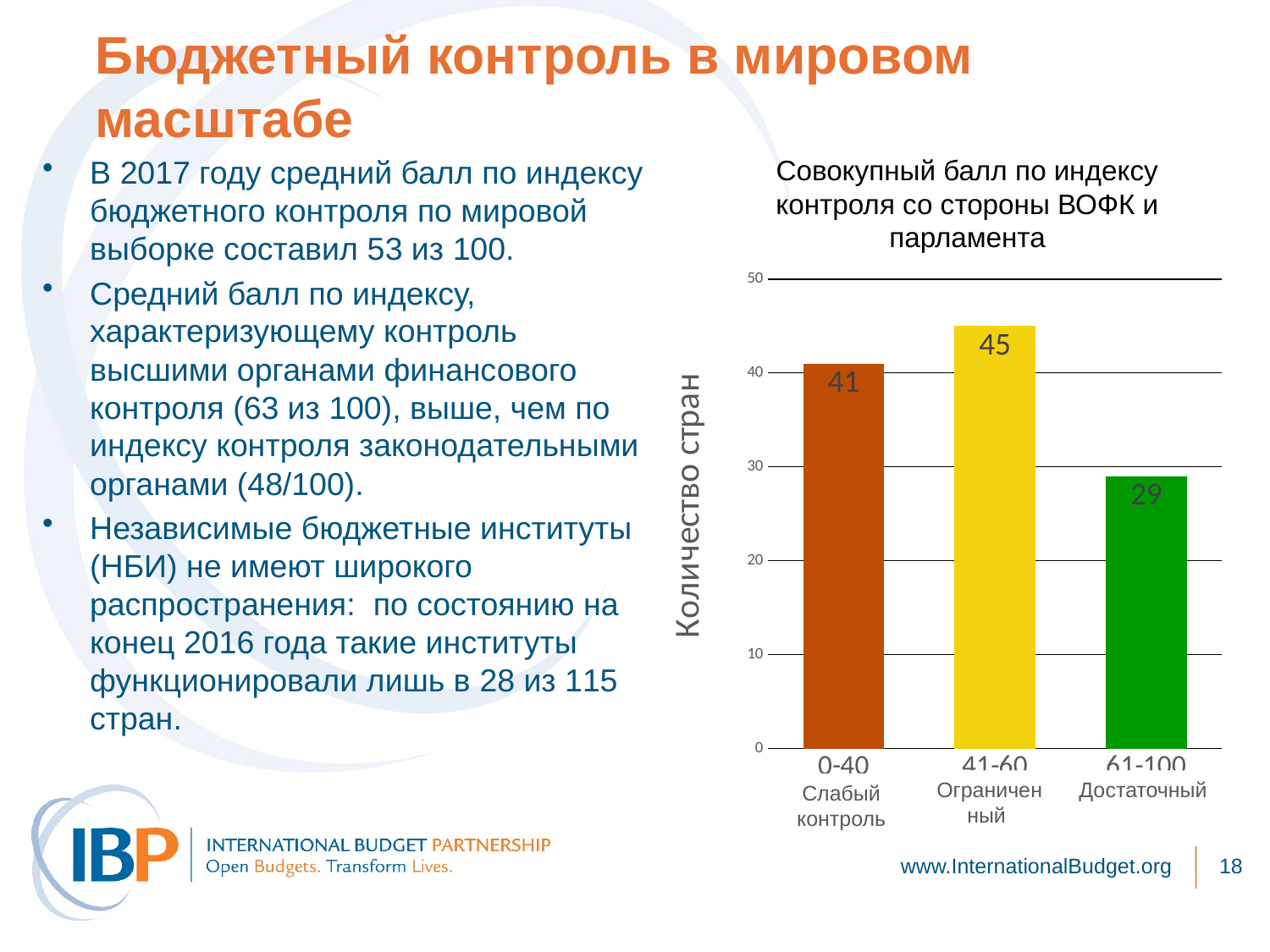
What is the value for the 41-60 (Ограниченный) category? 45 Which category has the highest number of countries? 41-60 (Ограниченный) What is the value for the 0-40 (Слабый контроль) category? 41 How many categories are shown in the chart? 3 What is the difference between the values for 41-60 and 0-40? 4 What is the difference between the values for 41-60 and 61-100? 16 What is the value for the 61-100 (Достаточный) category? 29 What is the label of the vertical axis of the chart? Количество стран What kind of chart is shown on the slide? bar chart Which category has the lowest number of countries? 61-100 (Достаточный) Which is larger, the value for 0-40 or the value for 61-100? 0-40 Is the value for 61-100 greater or less than 30? less